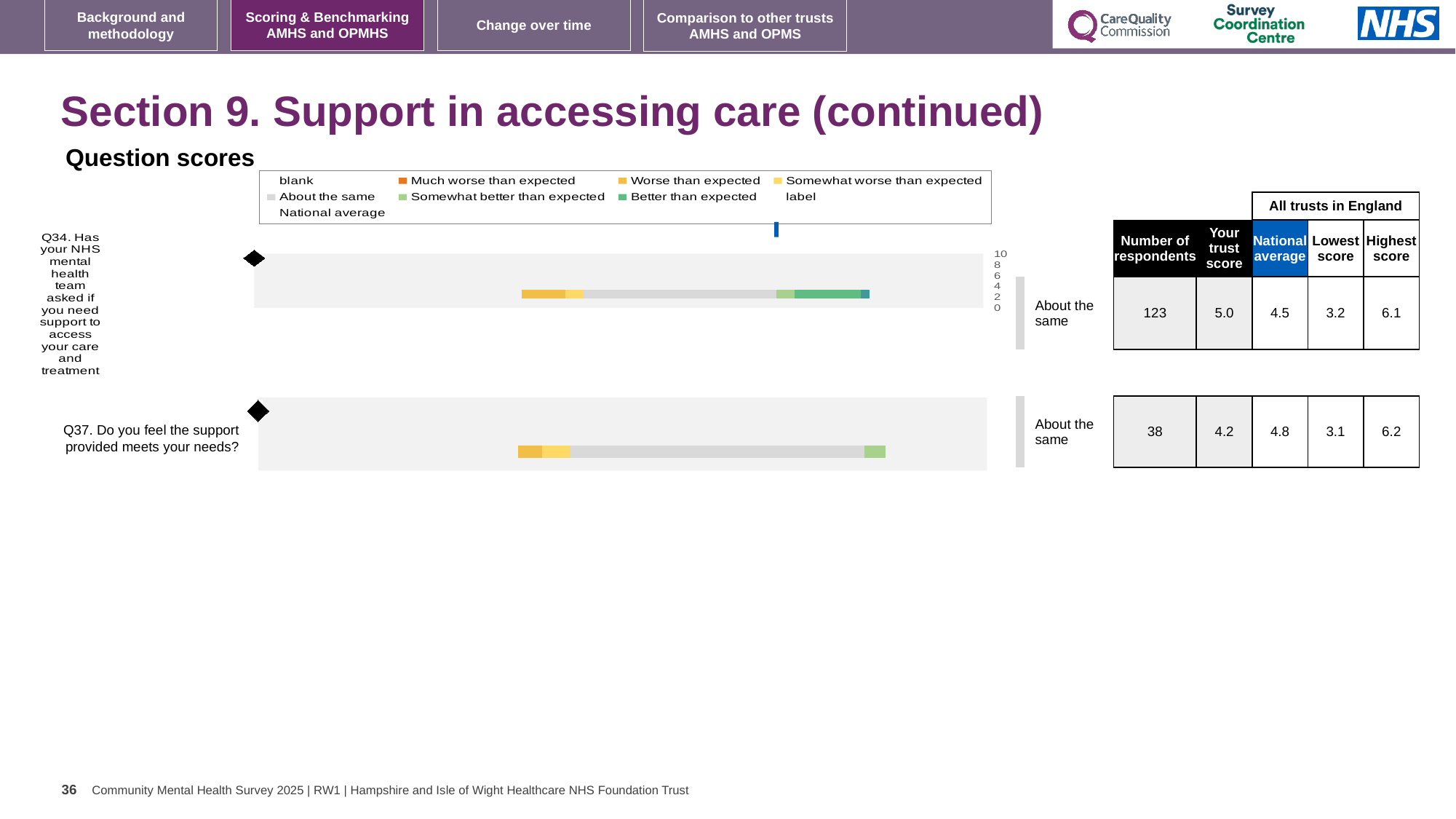
Which question has the higher trust score, Q34 or Q37? Q34 What benchmark category is shown next to the bar for Q37? About the same What is the highest score among all trusts in England for Q37? 6.2 What colour represents 'Much worse than expected' in the legend? orange How many questions are plotted in the question scores chart? 2 What is the trust score for Q37 (Do you feel the support provided meets your needs)? 4.2 What kind of chart is used to show the question scores for Q34 and Q37? bar chart Is the trust score for Q34 higher or lower than the national average for Q34? higher What is the trust score for Q34 (Has your NHS mental health team asked if you need support to access your care and treatment)? 5.0 What is the national average score for Q37? 4.8 What is the difference between the highest score and the lowest score for Q34? 2.9 How many respondents answered Q34? 123